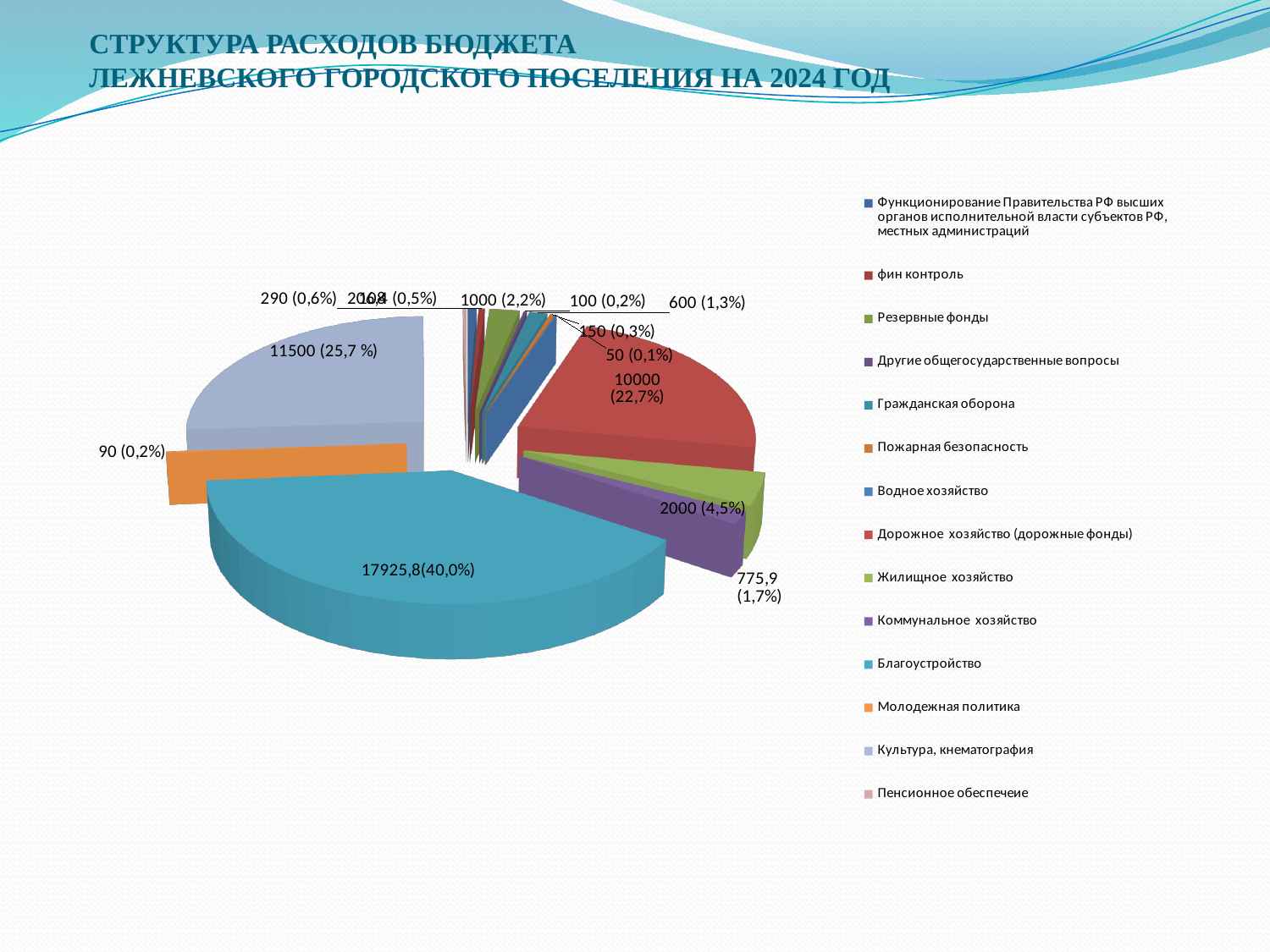
What is the difference between the slice labelled 11500 and the slice labelled 10000? 1500 What share of the pie does the slice labelled 775,9 represent? 1,7% What share of the pie does the slice labelled 11500 represent? 25,7 % What is the title of the slide containing the pie chart? СТРУКТУРА РАСХОДОВ БЮДЖЕТА ЛЕЖНЕВСКОГО ГОРОДСКОГО ПОСЕЛЕНИЯ НА 2024 ГОД Which is larger: the slice labelled 10000 or the slice labelled 11500? 11500 What share of the pie does the slice labelled 2000 represent? 4,5% How many entries does the legend of the pie chart list? 14 What is the value shown for the largest slice of the pie chart? 17925,8 What is the smallest value labelled on the pie chart? 50 What kind of chart is shown on the slide? pie chart